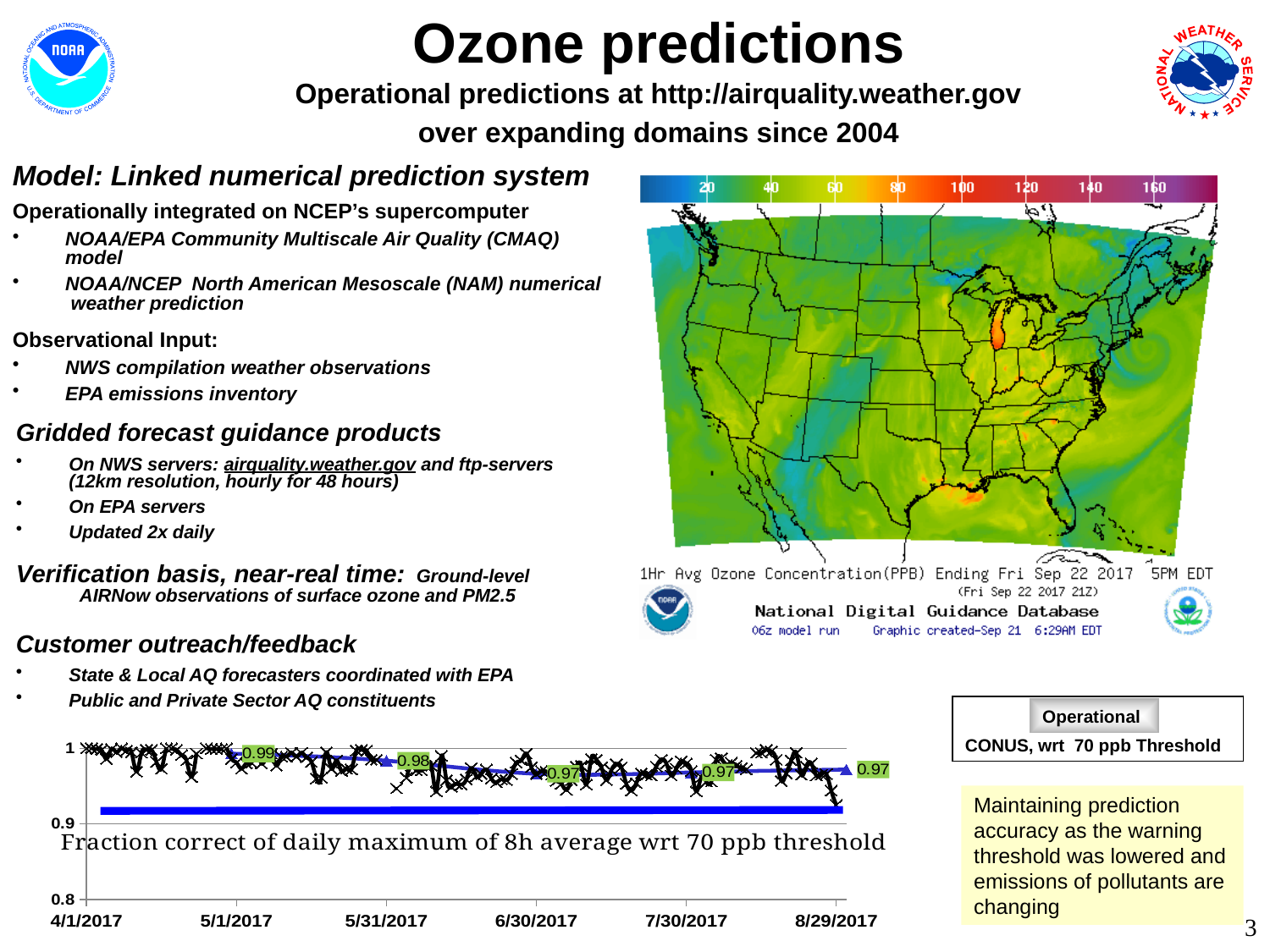
What is the title text printed inside the line chart at the bottom of the slide? Fraction correct of daily maximum of 8h average wrt 70 ppb threshold What is the lowest value shown on the y axis of the line chart at the bottom of the slide? 0.8 In the line chart at the bottom of the slide, what is the lowest data label value shown? 0.97 In the line chart at the bottom of the slide, is the labeled value at the right end of the blue line greater or less than 0.9? greater In the line chart at the bottom of the slide, what is the first (leftmost) data label shown on the blue line? 0.99 What kind of chart is shown at the bottom left of the slide? line chart In the line chart at the bottom of the slide, what is the difference between the first data label (0.99) and the last data label (0.97)? 0.02 In the line chart at the bottom of the slide, what is the second data label shown on the blue line? 0.98 How many date labels are shown on the x axis of the line chart at the bottom of the slide? 6 In the line chart at the bottom of the slide, what is the highest data label value shown? 0.99 In the line chart at the bottom of the slide, do the labeled values on the blue line rise or fall from left to right along the x axis? fall In the line chart at the bottom of the slide, what is the last (rightmost) data label shown on the blue line? 0.97